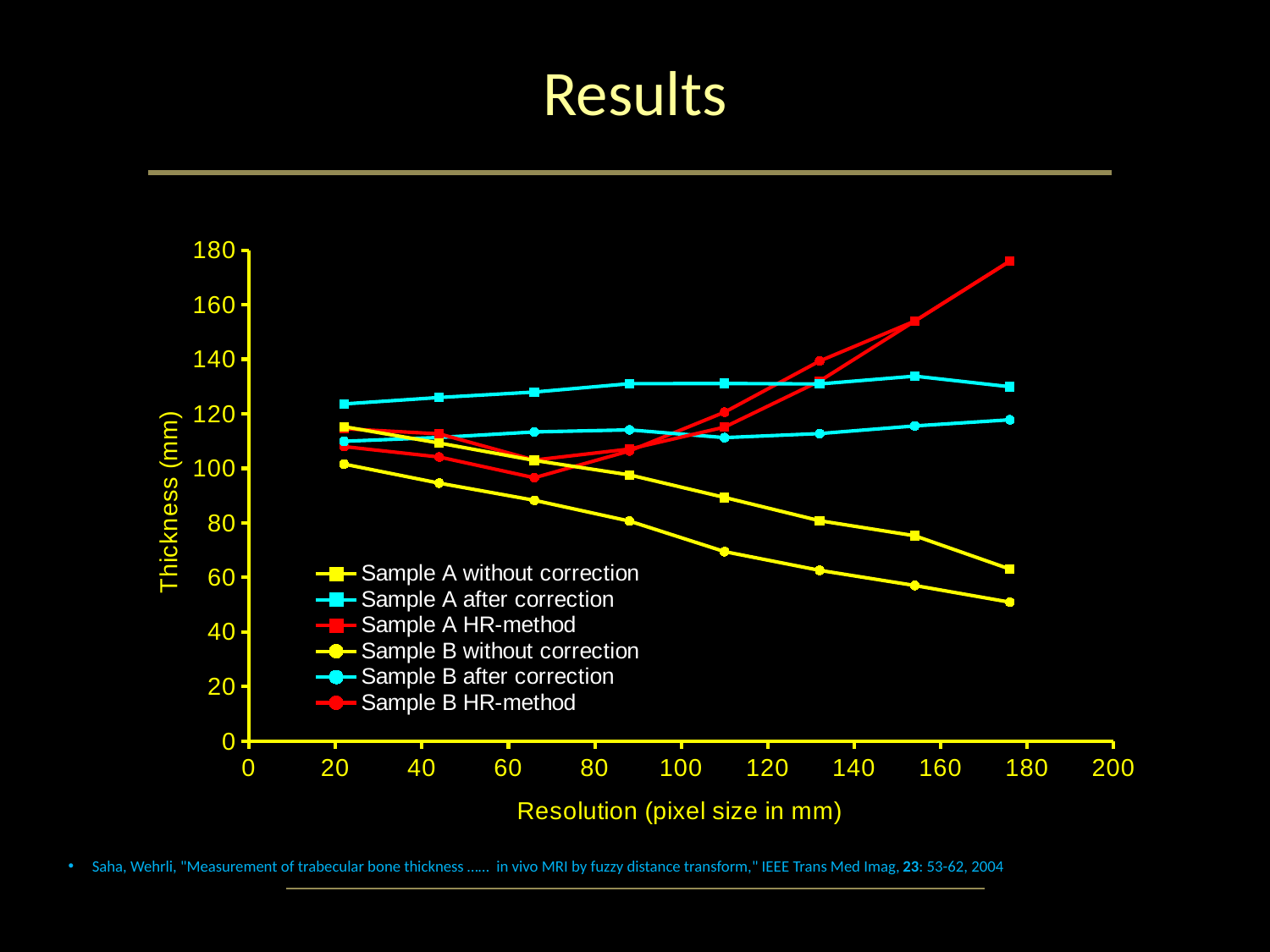
How many data points does the Sample A without correction series have? 8 Do the values for Sample B without correction rise or fall as resolution increases? fall How many series does the legend list? 6 What kind of chart is shown on the slide? line chart Is the value for Sample B HR-method at resolution 132 greater or less than 120? greater Which series has the lowest value at resolution 176? Sample B without correction Do the values for Sample A without correction rise or fall as resolution increases? fall What is the title of the y axis? Thickness (mm) Is the value for Sample A HR-method at resolution 176 greater or less than 160? greater What is the title of the x axis? Resolution (pixel size in mm) Is the value for Sample A after correction at resolution 154 greater or less than 120? greater